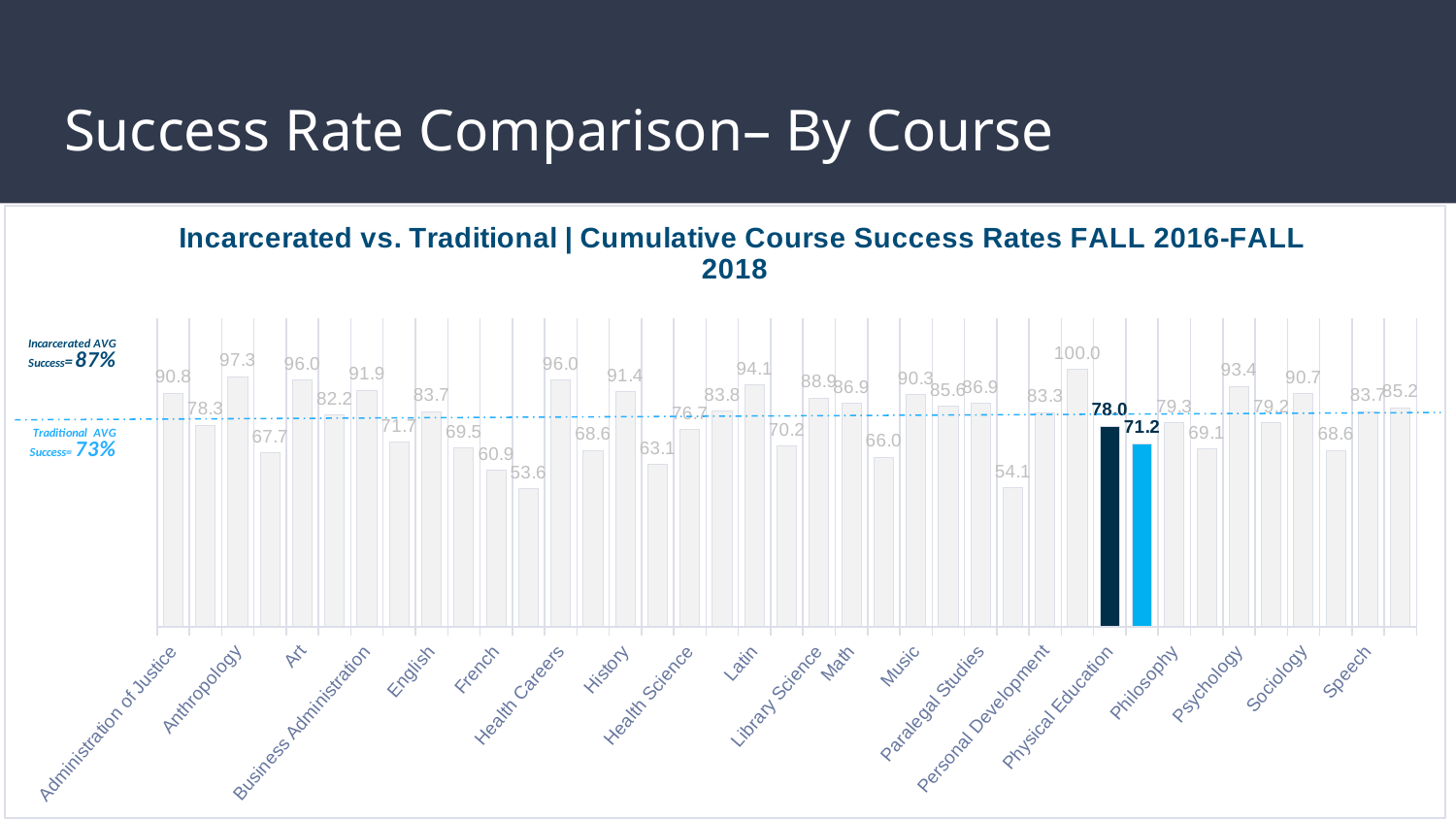
How many courses are listed along the x axis of the chart? 20 What is the highest value labeled on any bar in the chart? 100.0 What is the difference between the two highlighted Physical Education bars (78.0 and 71.2)? 6.8 What is the Incarcerated AVG Success rate shown on the chart? 87% What is the Traditional AVG Success rate shown on the chart? 73% What is the lowest value labeled on any bar in the chart? 53.6 What is the difference between the Incarcerated AVG Success rate and the Traditional AVG Success rate? 14 percentage points What value is labeled on the dark navy highlighted bar for Physical Education? 78.0 What value is labeled on the light blue highlighted bar for Physical Education? 71.2 What type of chart is shown on the slide? bar chart What is the title of the chart? Incarcerated vs. Traditional | Cumulative Course Success Rates FALL 2016-FALL 2018 What value is labeled on the leftmost bar of the chart (Administration of Justice)? 90.8